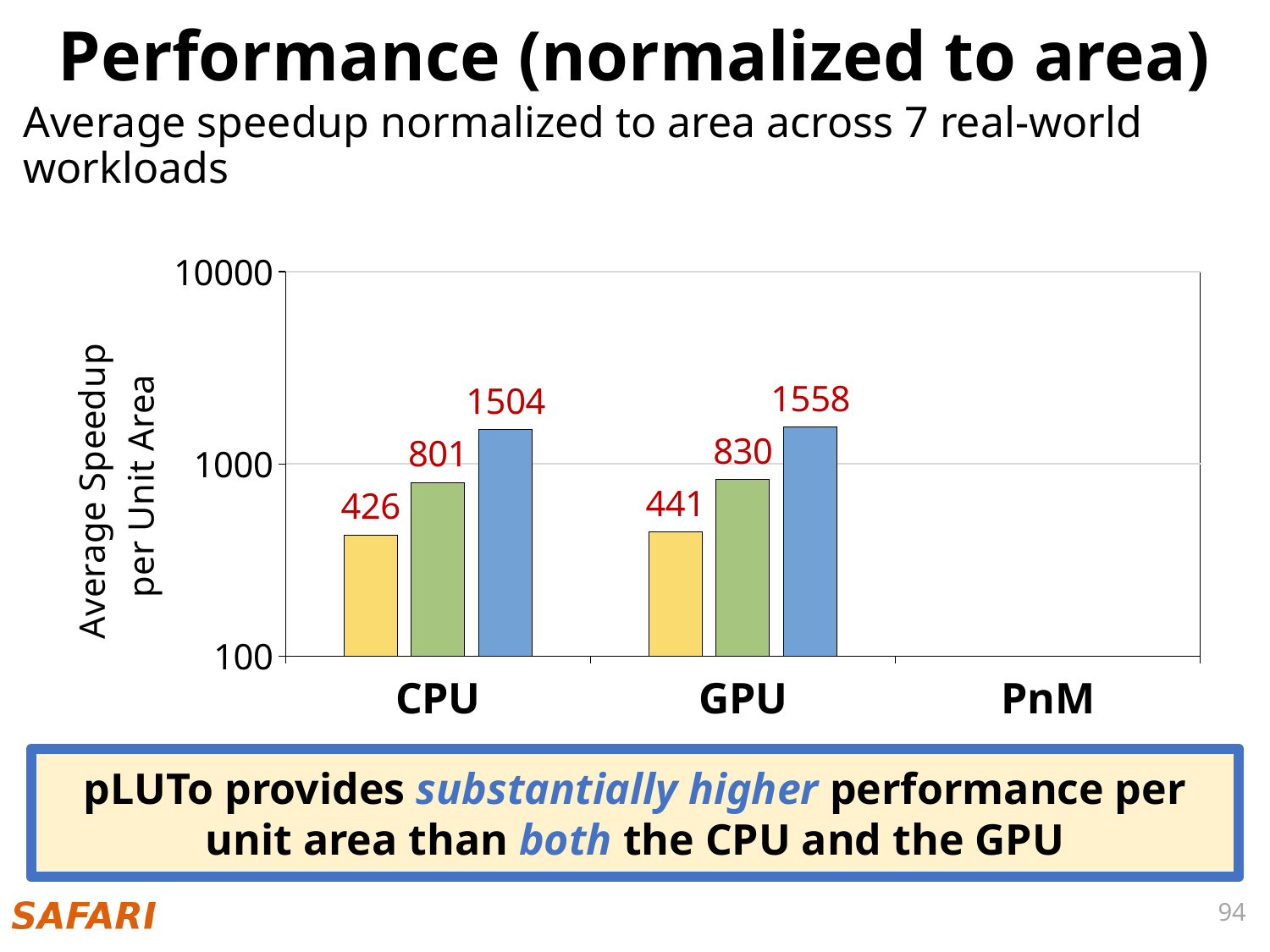
What is the label of the y axis? Average Speedup per Unit Area Which bar has the highest value in the chart? the blue bar for GPU (1558) What is the difference between the blue bar for GPU and the blue bar for CPU? 54 Which is larger, the green bar for GPU or the green bar for CPU? the green bar for GPU What is the difference between the green bar and the yellow bar for CPU? 375 What is the value of the yellow bar for GPU? 441 How many categories are labeled on the x axis? 3 What type of chart is shown on the slide? bar chart Which bar has the lowest value in the chart? the yellow bar for CPU (426) What is the value of the blue bar for GPU? 1558 What is the value of the green bar for CPU? 801 What is the value of the yellow bar for CPU? 426